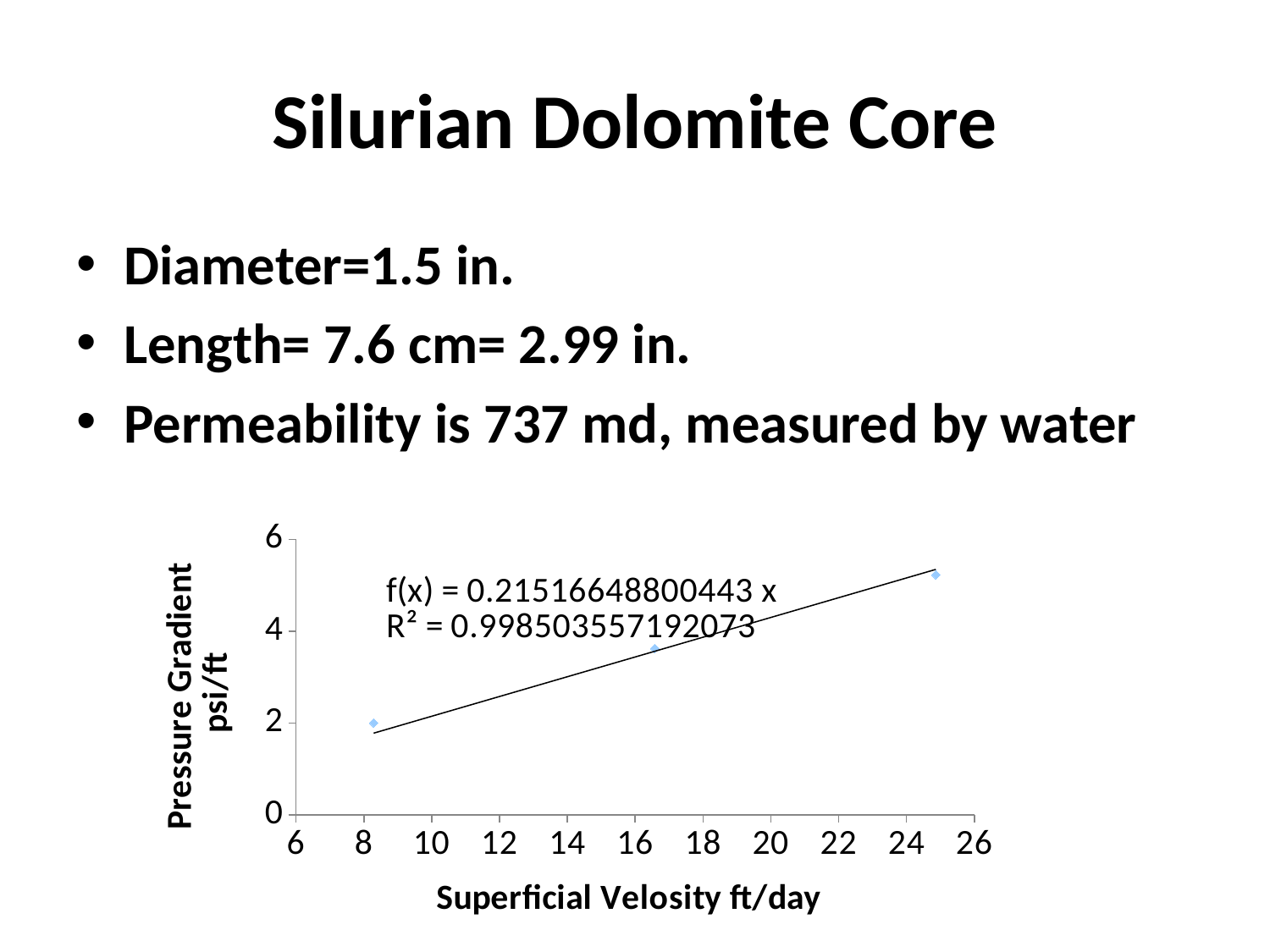
Which data point has the highest pressure gradient: the one at the lowest velocity or the one at the highest velocity? The one at the highest velocity What is the title of the y axis of the chart? Pressure Gradient psi/ft Is the pressure gradient for the middle data point (near 16-17 ft/day) greater or less than 2? greater Is the pressure gradient for the rightmost data point (near 25 ft/day) greater or less than 4? greater What is the R² value shown on the chart? 0.998503557192073 What is the title of the x axis of the chart? Superficial Velosity ft/day What is the maximum value shown on the y axis of the chart? 6 Do the plotted pressure gradient values rise or fall as superficial velocity increases? Rise Is the pressure gradient for the leftmost data point (near 8 ft/day) greater or less than 4? less What kind of chart is shown on the slide? Scatter chart How many data points are plotted on the chart? 3 What is the trendline equation shown on the chart? f(x) = 0.21516648800443 x